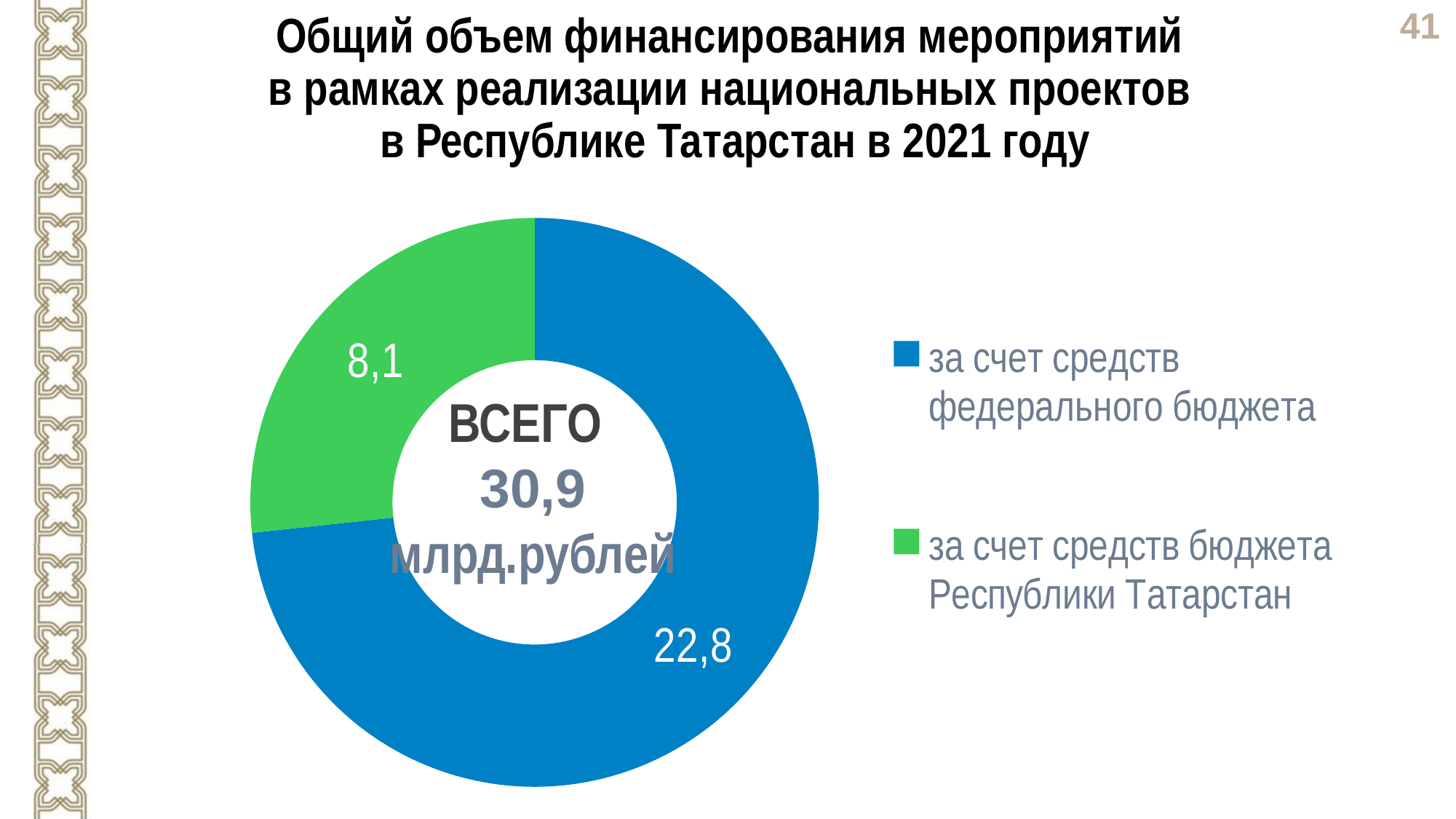
What colour is the slice for 'за счет средств бюджета Республики Татарстан'? Green Which slice is the smallest in the chart? за счет средств бюджета Республики Татарстан What is the value for the slice 'за счет средств федерального бюджета'? 22,8 What is the value for the slice 'за счет средств бюджета Республики Татарстан'? 8,1 Which slice is the largest in the chart? за счет средств федерального бюджета What is the difference between the federal budget value and the Republic of Tatarstan budget value? 14,7 Which is larger: the federal budget slice or the Republic of Tatarstan budget slice? за счет средств федерального бюджета How many entries does the legend list? 2 What share of the total does the federal budget slice (22,8 of 30,9) represent, to one decimal place? 73,8% What kind of chart is shown on the slide? Donut (pie) chart What total is shown in the centre of the chart? 30,9 млрд.рублей How many slices does the chart have? 2